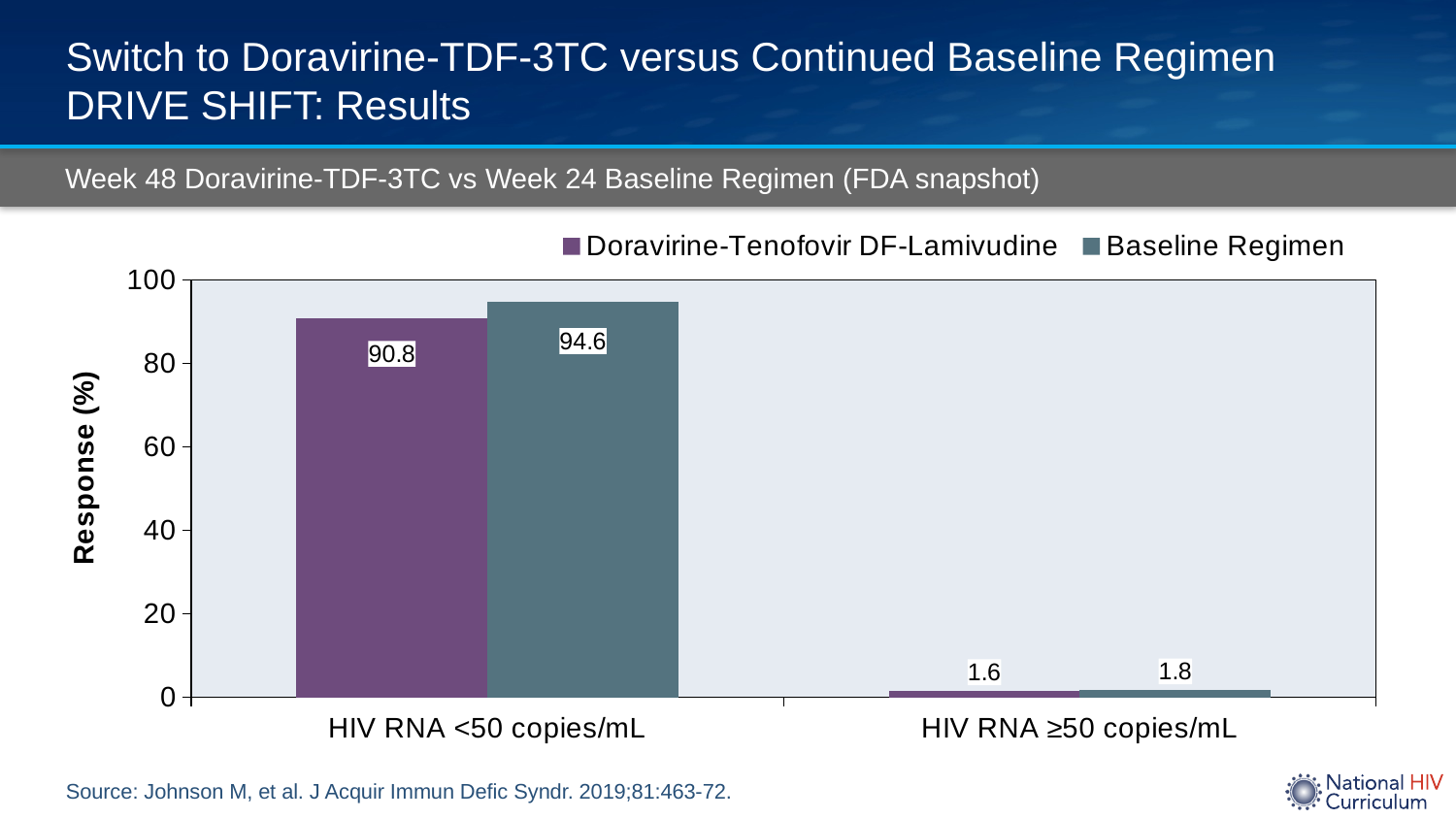
What is the difference between the Baseline Regimen and Doravirine-Tenofovir DF-Lamivudine values in the HIV RNA ≥50 copies/mL category? 0.2 What is the value for Doravirine-Tenofovir DF-Lamivudine in the HIV RNA <50 copies/mL category? 90.8 What kind of chart is shown on the slide? bar chart What is the value for Baseline Regimen in the HIV RNA <50 copies/mL category? 94.6 What is the value for Baseline Regimen in the HIV RNA ≥50 copies/mL category? 1.8 Which series has the higher value in the HIV RNA <50 copies/mL category? Baseline Regimen Which category has the lowest value for Doravirine-Tenofovir DF-Lamivudine? HIV RNA ≥50 copies/mL How many categories are shown on the x axis? 2 What is the value for Doravirine-Tenofovir DF-Lamivudine in the HIV RNA ≥50 copies/mL category? 1.6 How many series does the legend list? 2 What is the difference between the Baseline Regimen and Doravirine-Tenofovir DF-Lamivudine values in the HIV RNA <50 copies/mL category? 3.8 Is the value for Baseline Regimen in the HIV RNA <50 copies/mL category greater or less than 80? greater